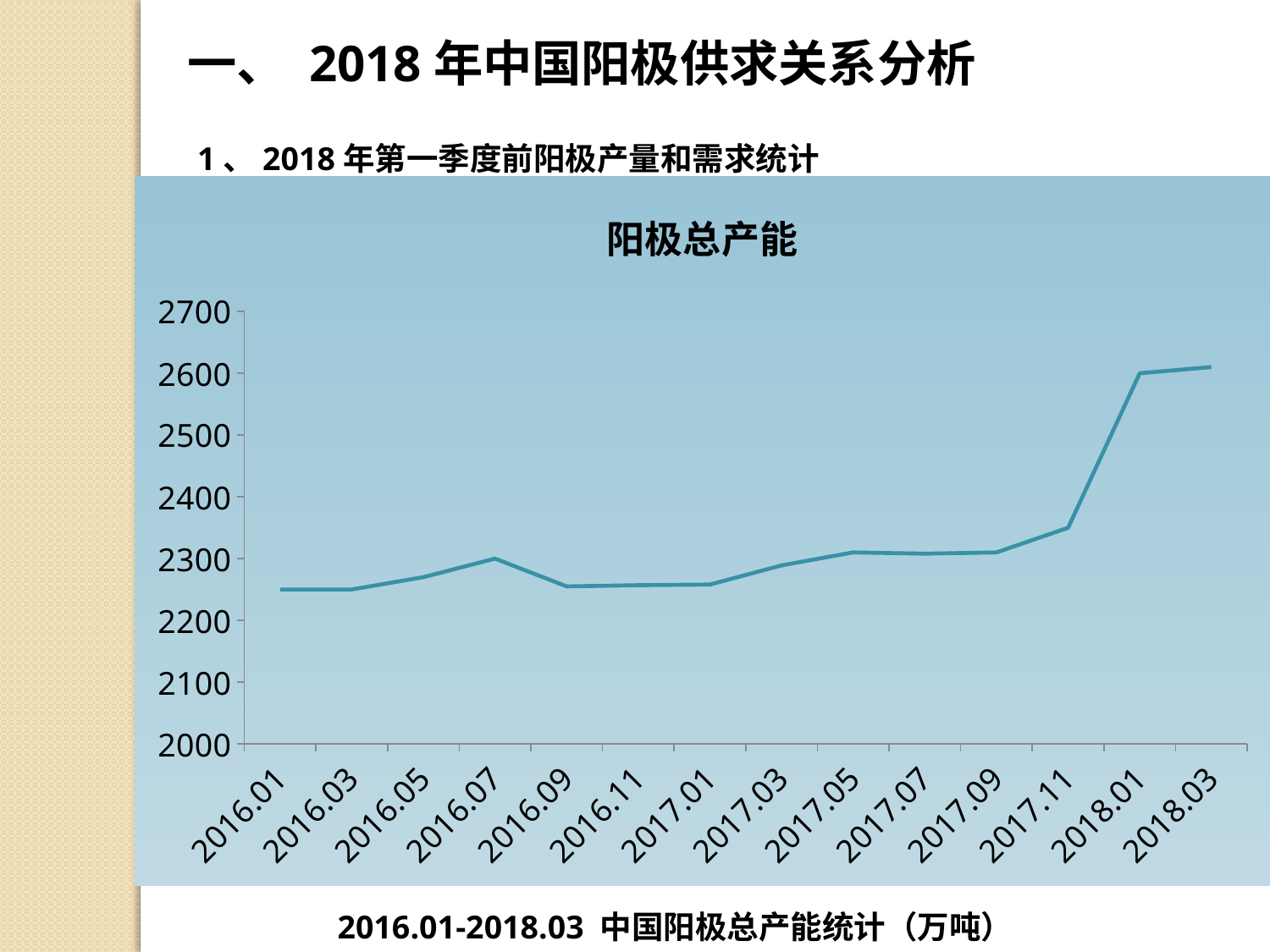
How many x-axis labels (time points) are shown on the chart? 14 Which time point has the highest value on the chart? 2018.03 What is the value for 2016.07? 2300 Overall, do the values rise or fall from 2016.01 to 2018.03? rise What kind of chart is shown on the slide? line chart Is the value for 2018.03 greater or less than 2600? greater What is the title of the chart? 阳极总产能 Which is larger, the value for 2018.03 or the value for 2016.01? 2018.03 Is the value for 2016.09 greater or less than 2300? less Is the value for 2016.01 greater or less than 2300? less What is the value for 2018.01? 2600